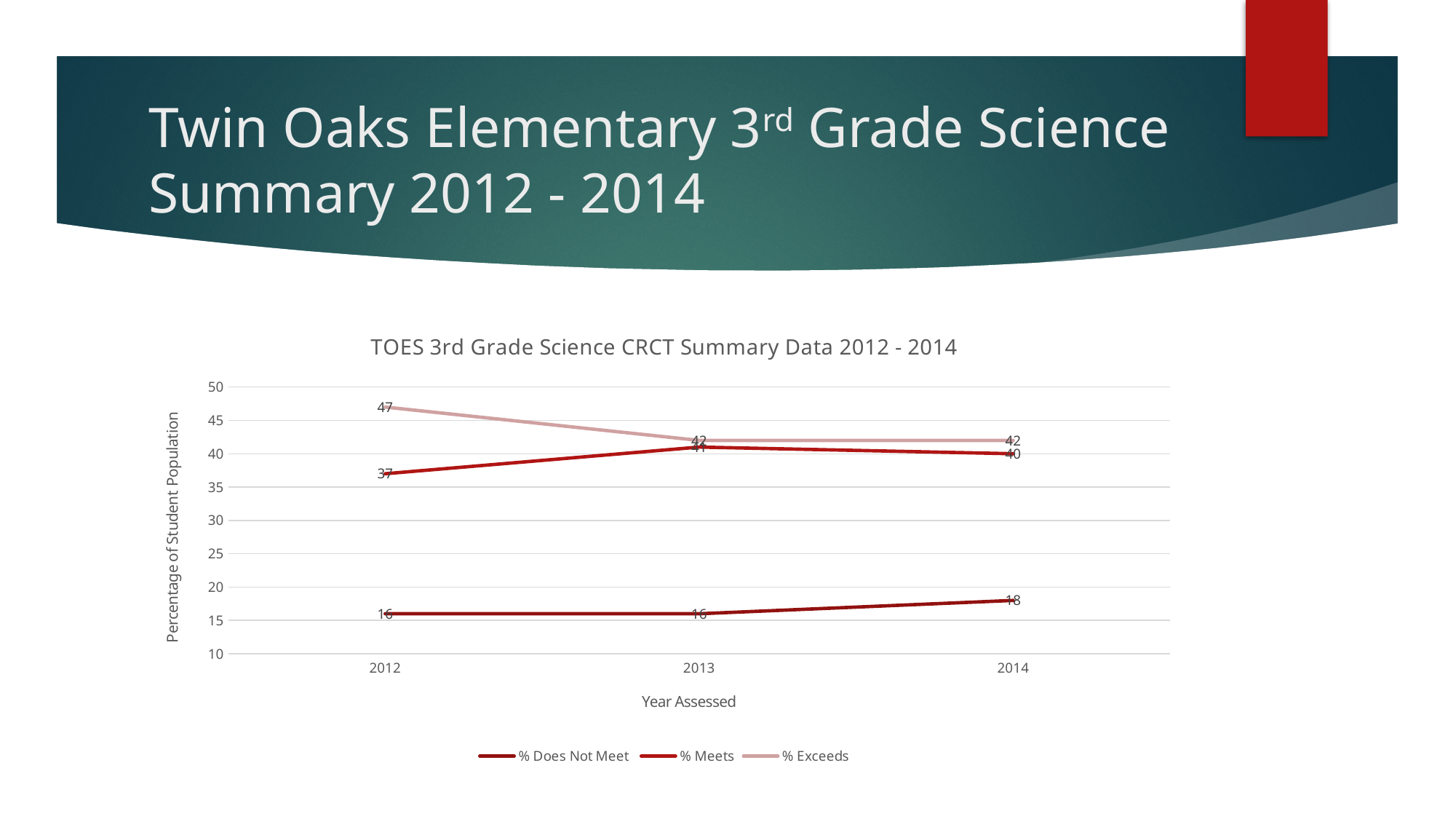
What is the title of the chart? TOES 3rd Grade Science CRCT Summary Data 2012 - 2014 What is the % Meets value for 2014? 40 What type of chart is shown on the slide? Line chart What is the % Does Not Meet value for 2013? 16 How many years are plotted on the x axis? 3 What is the difference between the % Exceeds value in 2012 and in 2014? 5 In which year is the % Exceeds value highest? 2012 In which year is the % Meets value lowest? 2012 Does the % Exceeds series rise or fall from 2012 to 2013? Fall What is the % Exceeds value for 2012? 47 How many series does the legend list? 3 Which is larger in 2012: % Exceeds or % Meets? % Exceeds